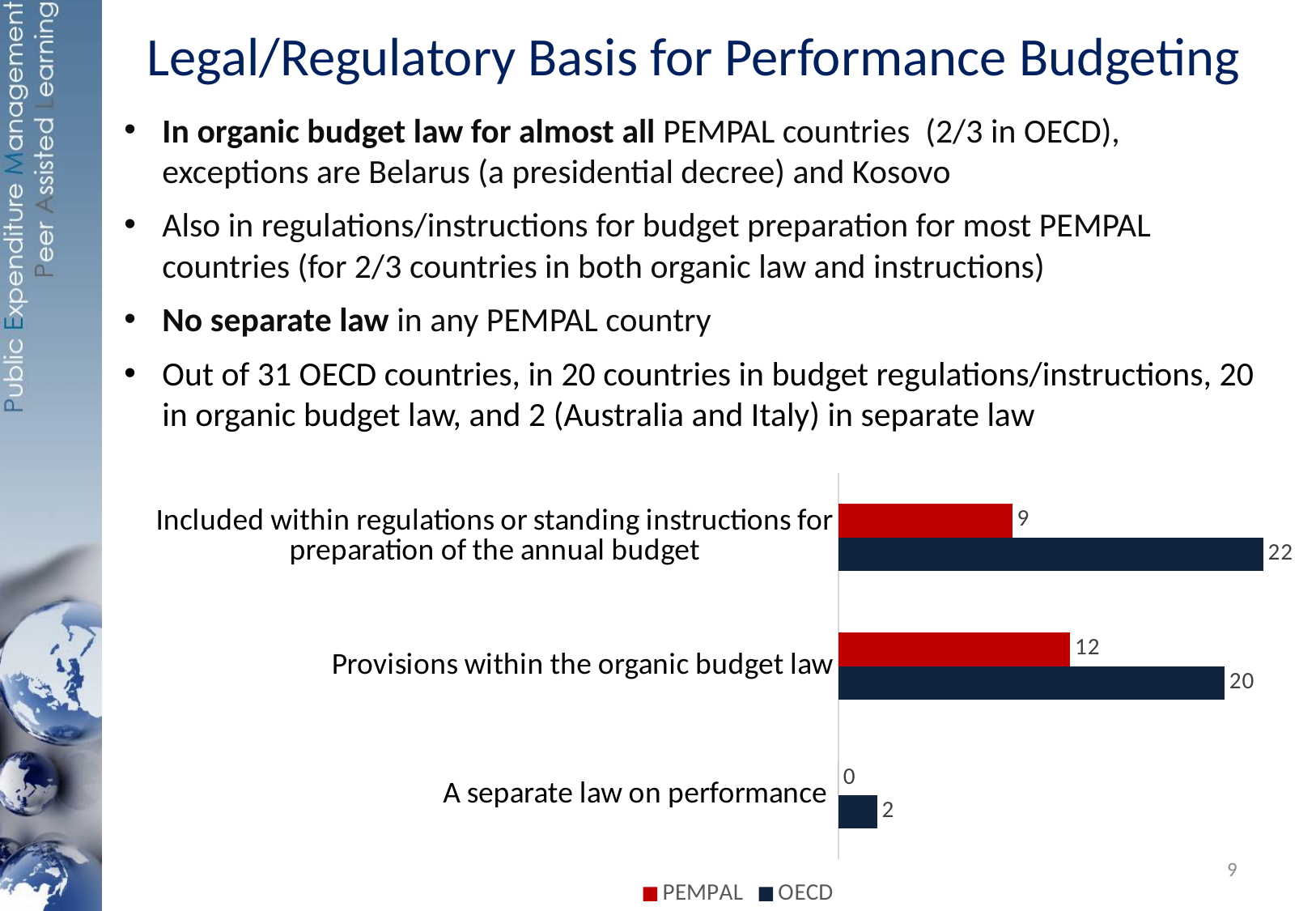
Which category has the highest PEMPAL value? Provisions within the organic budget law Which is larger for 'Provisions within the organic budget law': the PEMPAL value or the OECD value? OECD Which colour represents the OECD series in the chart? Dark navy blue What is the OECD value for 'A separate law on performance'? 2 What is the OECD value for 'Included within regulations or standing instructions for preparation of the annual budget'? 22 What is the PEMPAL value for 'Provisions within the organic budget law'? 12 Which category has the lowest OECD value? A separate law on performance How many series does the legend list? 2 What is the PEMPAL value for 'A separate law on performance'? 0 What is the difference between the OECD and PEMPAL values for 'Included within regulations or standing instructions for preparation of the annual budget'? 13 What kind of chart is shown on the slide? Bar chart How many categories are shown in the chart? 3